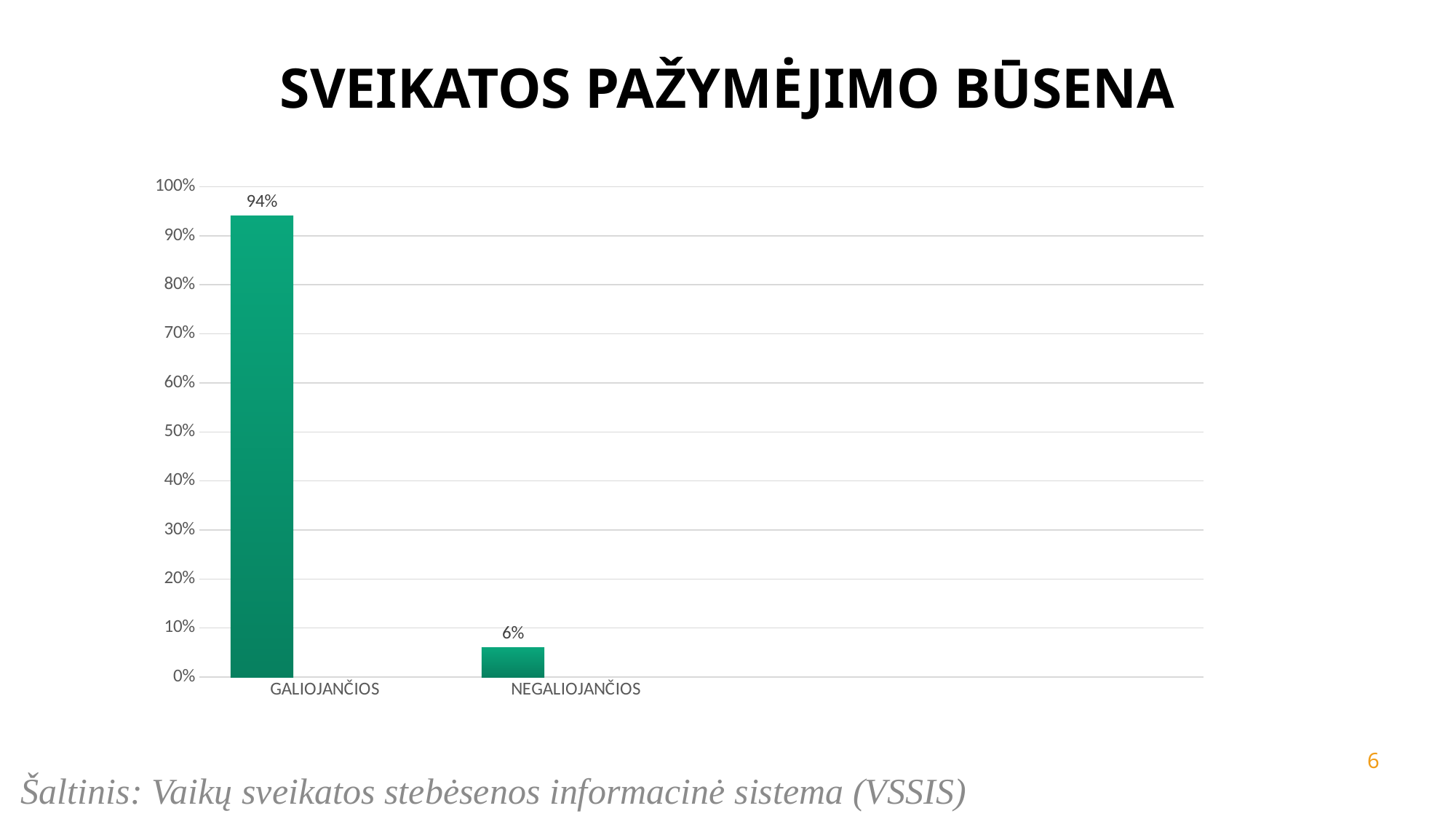
Which is larger, the value for GALIOJANČIOS or the value for NEGALIOJANČIOS? GALIOJANČIOS Which category has the highest value? GALIOJANČIOS What is the difference between the values for GALIOJANČIOS and NEGALIOJANČIOS? 88% Is the value for GALIOJANČIOS greater or less than 90%? greater What is the highest value shown on the y axis? 100% Is the value for NEGALIOJANČIOS greater or less than 10%? less What is the value for GALIOJANČIOS? 94% What is the title of the chart? SVEIKATOS PAŽYMĖJIMO BŪSENA What is the value for NEGALIOJANČIOS? 6% What kind of chart is shown on the slide? bar chart How many categories are shown on the x axis? 2 Which category has the lowest value? NEGALIOJANČIOS